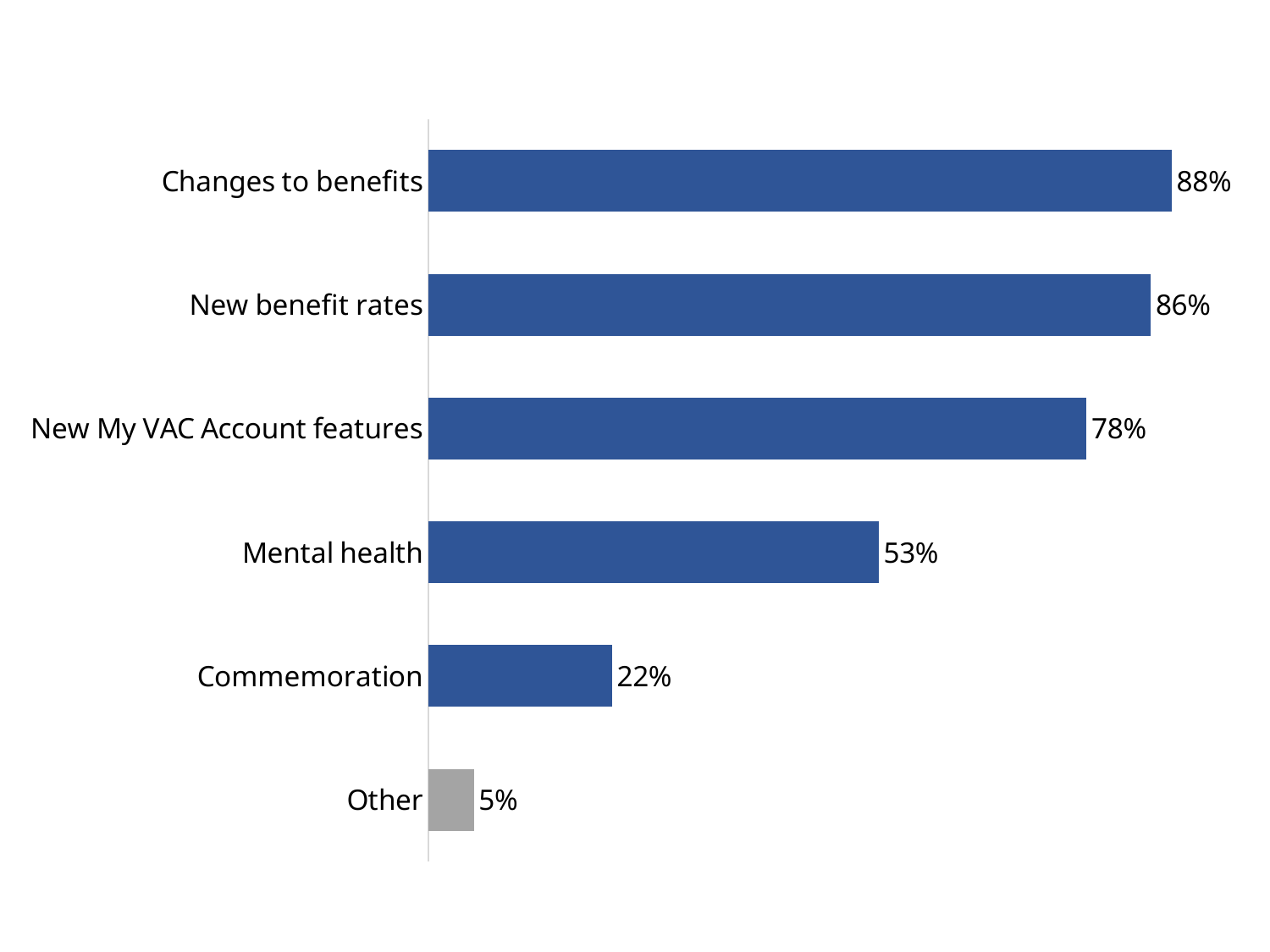
What is the difference between the values for Changes to benefits and New benefit rates? 2% What kind of chart is this? Bar chart Which bar is coloured differently from the others? Other Which is larger, the value for Mental health or the value for Commemoration? Mental health How many categories are shown in the chart? 6 What is the value for Commemoration? 22% What is the value for New My VAC Account features? 78% What is the difference between the values for New benefit rates and Mental health? 33% What is the value for Changes to benefits? 88% Which category has the highest value? Changes to benefits Which category has the lowest value? Other What is the value for Other? 5%